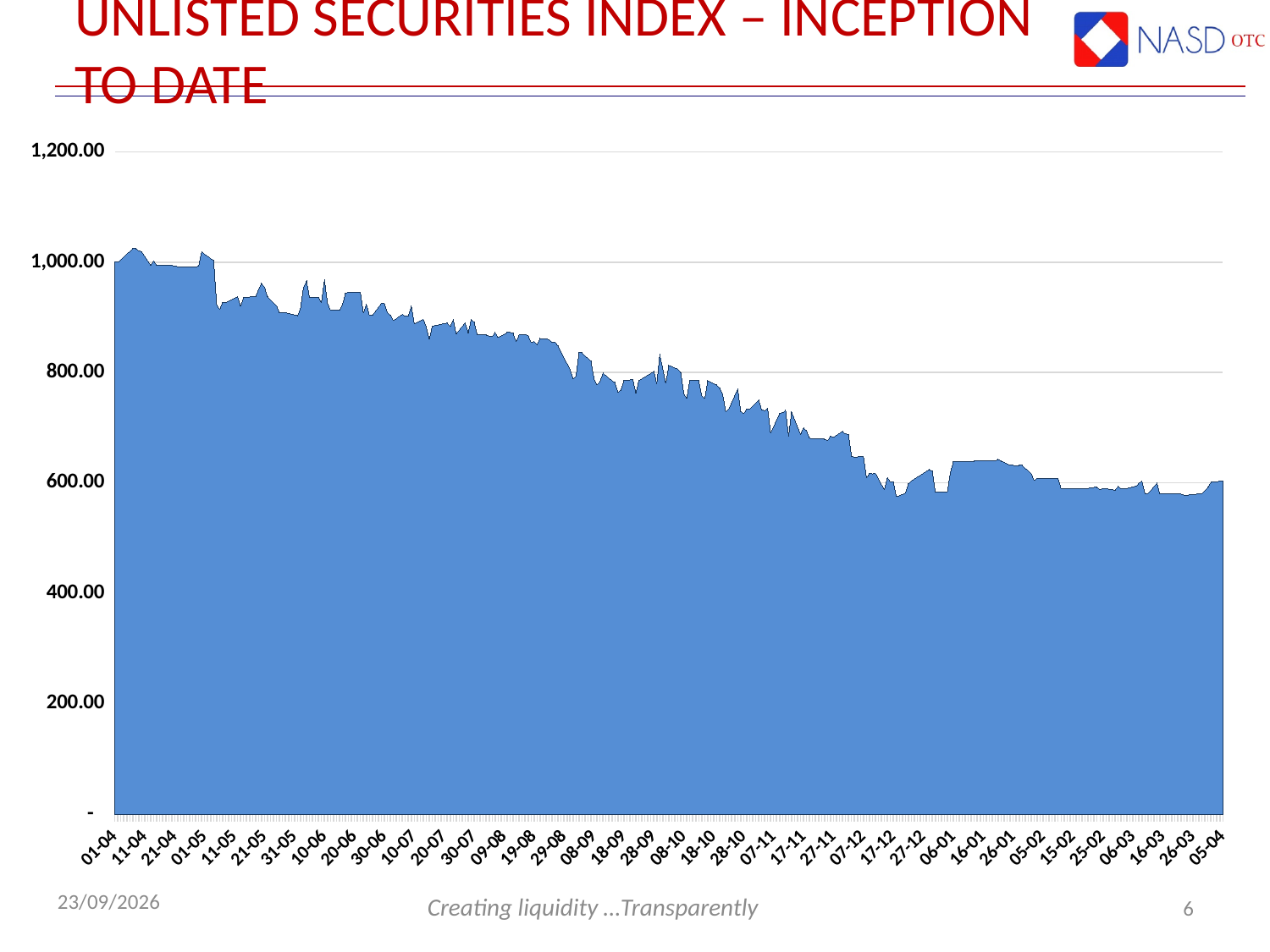
What kind of chart is shown on the slide? Area chart What is the highest value shown on the y axis? 1,200.00 Is the index value at 11-05 greater or less than 800? greater Is the index value at 16-01 greater or less than 600? greater Which date has the higher index value, 11-05 or 07-11? 11-05 Which date has the higher index value, 01-04 or 05-04? 01-04 Is the index value at 11-05 greater or less than 1,000? less Does the index generally rise or fall from 01-04 to 05-04 along the x axis? Fall What is the title of the chart on the slide? UNLISTED SECURITIES INDEX – INCEPTION TO DATE